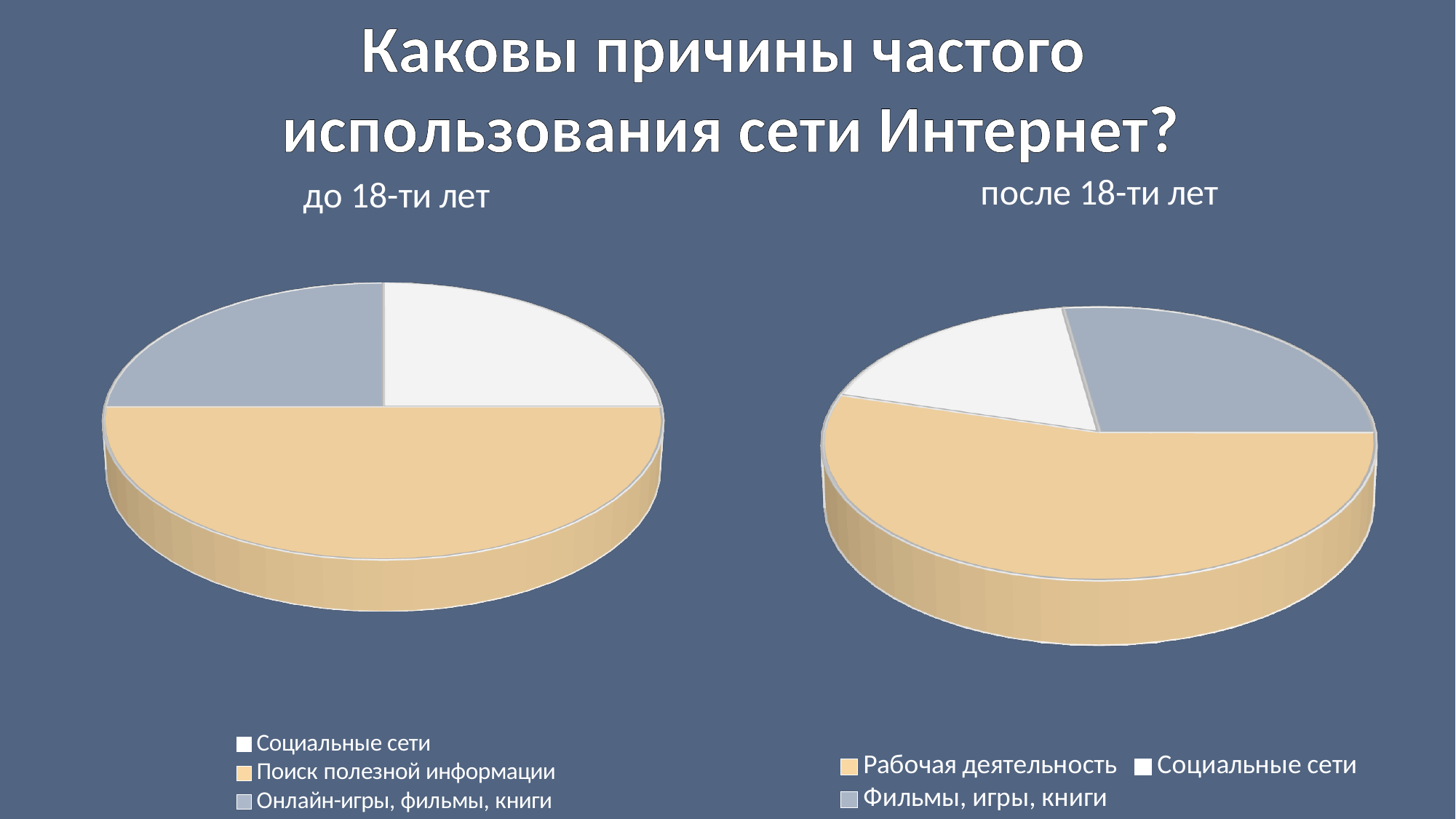
What kind of chart is the chart titled "до 18-ти лет"? pie chart In the chart titled "после 18-ти лет", which category has the largest slice? Рабочая деятельность How many slices does the chart titled "до 18-ти лет" have? 3 In the chart titled "после 18-ти лет", which slice is larger: Фильмы, игры, книги or Социальные сети? Фильмы, игры, книги In the chart titled "после 18-ти лет", which category has the smallest slice? Социальные сети How many entries does the legend of the chart titled "после 18-ти лет" list? 3 How many slices does the chart titled "после 18-ти лет" have? 3 In the chart titled "до 18-ти лет", which category is shown in white? Социальные сети In the chart titled "до 18-ти лет", which slice is larger: Поиск полезной информации or Социальные сети? Поиск полезной информации In the chart titled "до 18-ти лет", which category has the largest slice? Поиск полезной информации What is the title of the pie chart on the right side of the slide? после 18-ти лет What kind of chart is the chart titled "после 18-ти лет"? pie chart